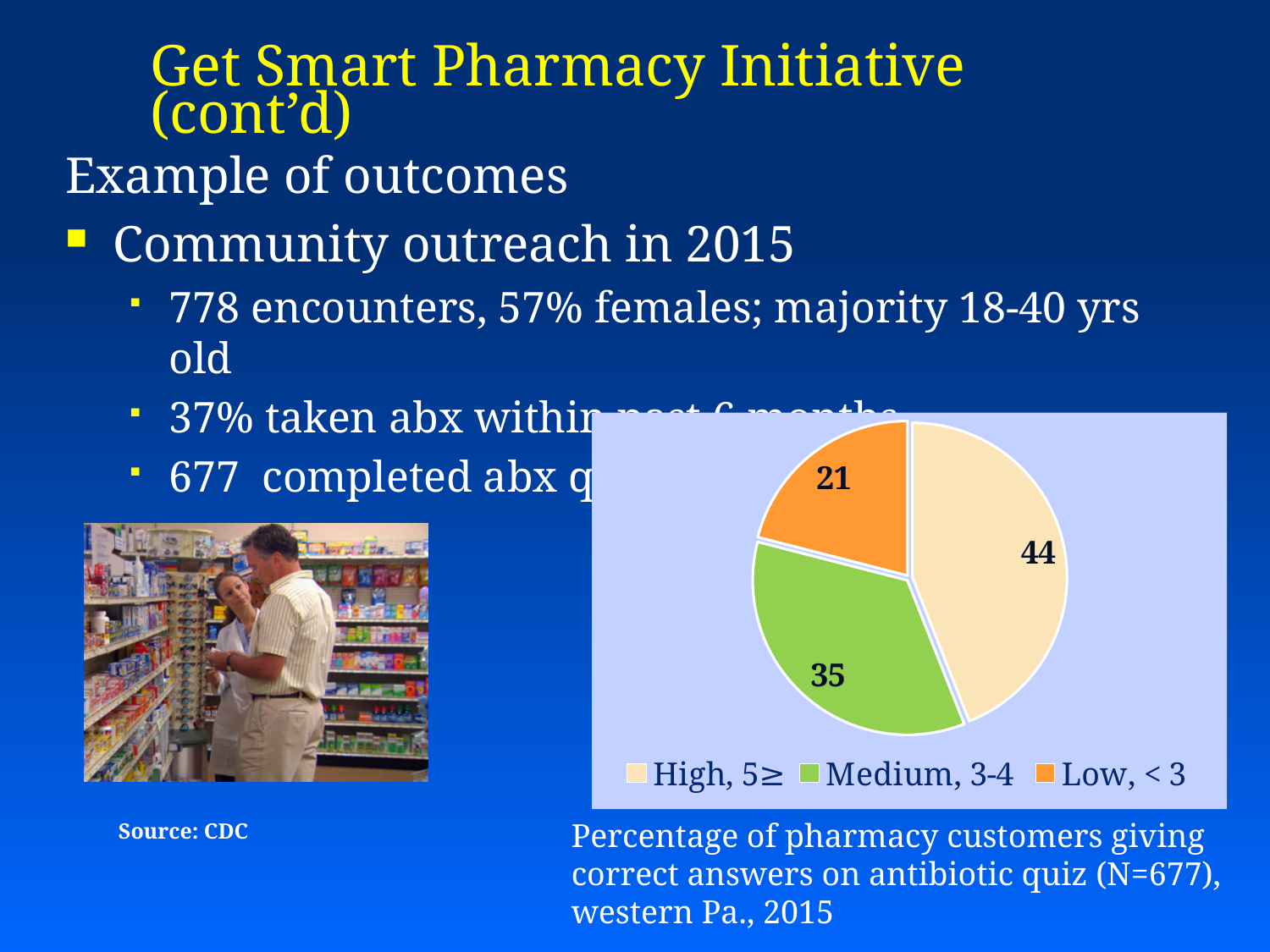
How many entries does the legend list? 3 What is the value for the "Low, < 3" slice? 21 Which is larger, the "Medium, 3-4" slice or the "Low, < 3" slice? Medium, 3-4 What colour is the "Low, < 3" slice? orange Which category has the smallest slice? Low, < 3 What is the difference between the "High, 5≥" and "Low, < 3" values? 23 What is the difference between the "High, 5≥" and "Medium, 3-4" values? 9 What kind of chart is shown on the slide? pie chart What is the value for the "High, 5≥" slice? 44 What is the value for the "Medium, 3-4" slice? 35 How many slices does the pie chart have? 3 Which category has the largest slice? High, 5≥